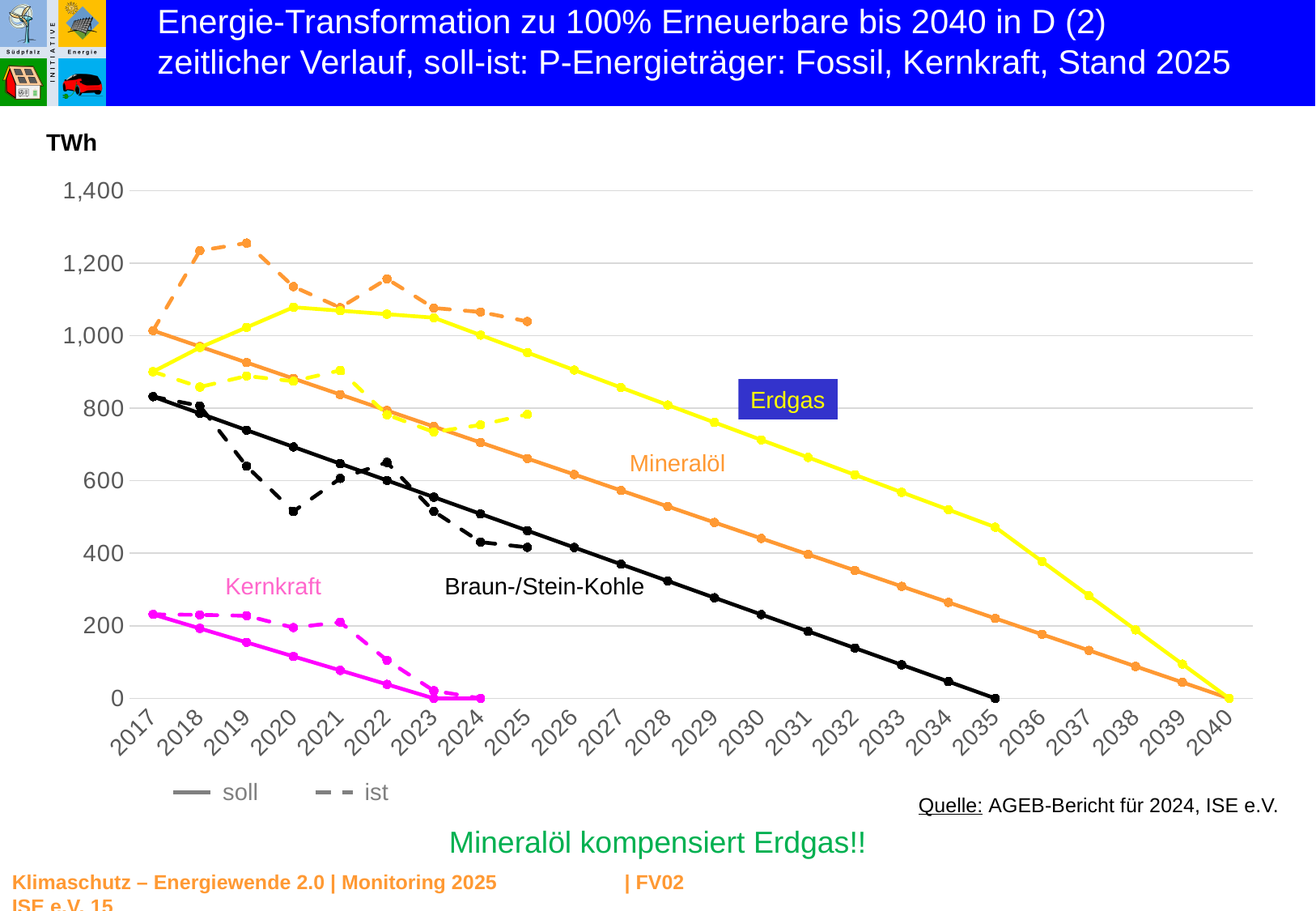
How many years are labelled on the x axis of the chart? 24 Which energy carrier has the lowest soll value in 2017? Kernkraft In 2017, which ist value is higher: Erdgas or Mineralöl? Mineralöl How many line styles does the legend below the chart list? 2 In which year does the Braun-/Stein-Kohle soll line reach 0 TWh? 2035 In which year does the Kernkraft soll line first reach 0 TWh? 2023 Is the Braun-/Stein-Kohle ist value for 2020 greater or less than 600 TWh? less Does the Erdgas soll line rise or fall from 2020 to 2040? fall What kind of chart is shown on the slide? line chart Is the Erdgas ist value for 2019 greater or less than 1,200 TWh? less In which year does the Erdgas soll line reach 0 TWh? 2040 Which energy carrier has the highest soll value in 2030? Erdgas